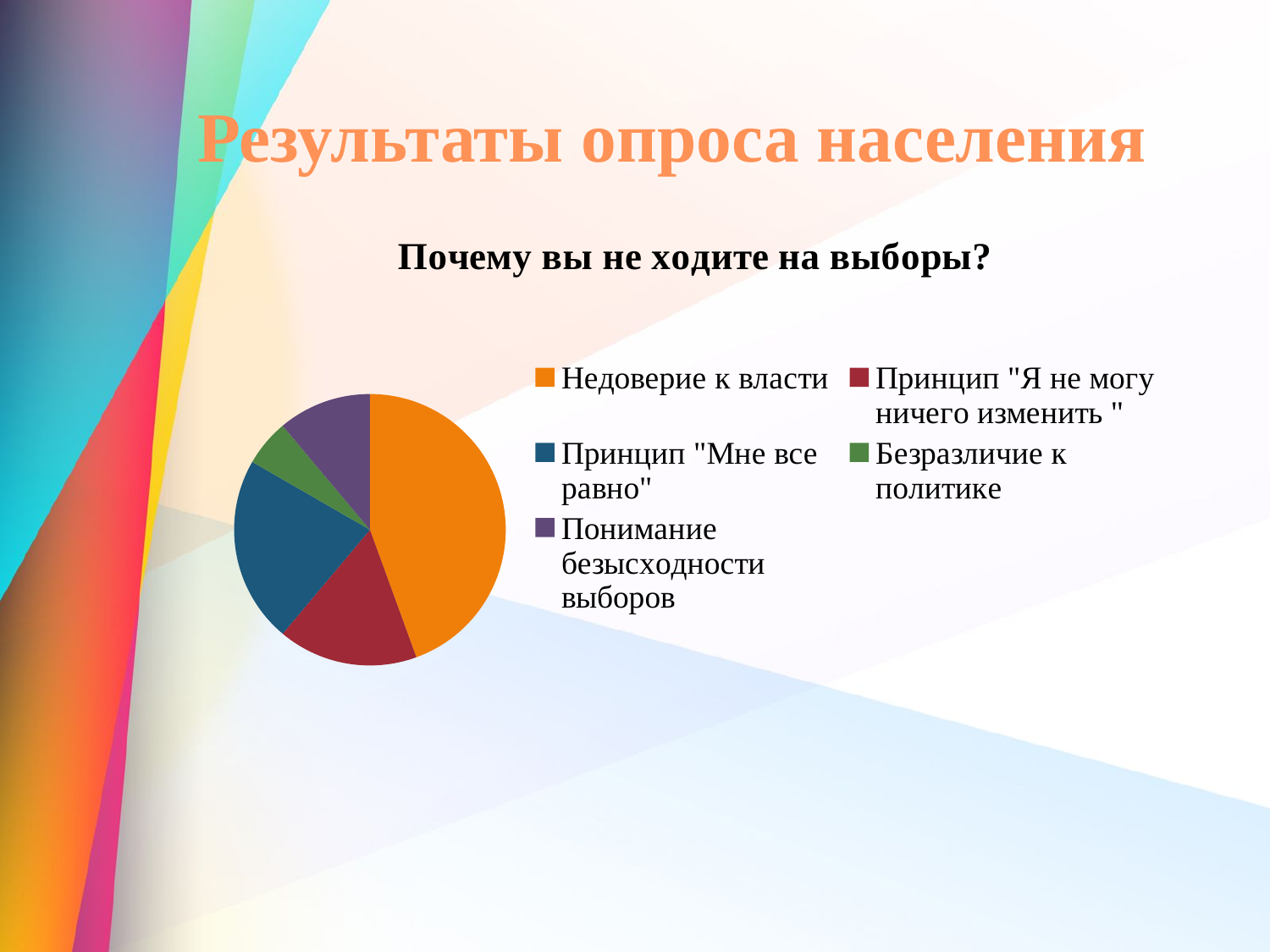
Which category has the largest slice of the pie? Недоверие к власти Which colour represents Недоверие к власти in the pie chart? orange How many entries does the legend list? 5 How many categories does the pie chart have? 5 Which slice is larger: Понимание безысходности выборов or Безразличие к политике? Понимание безысходности выборов What kind of chart is shown on the slide? pie chart Which slice is larger: Принцип "Я не могу ничего изменить" or Безразличие к политике? Принцип "Я не могу ничего изменить" Which slice is larger: Недоверие к власти or Принцип "Мне все равно"? Недоверие к власти Which category has the smallest slice of the pie? Безразличие к политике What question is the pie chart answering, according to the text above it? Почему вы не ходите на выборы?